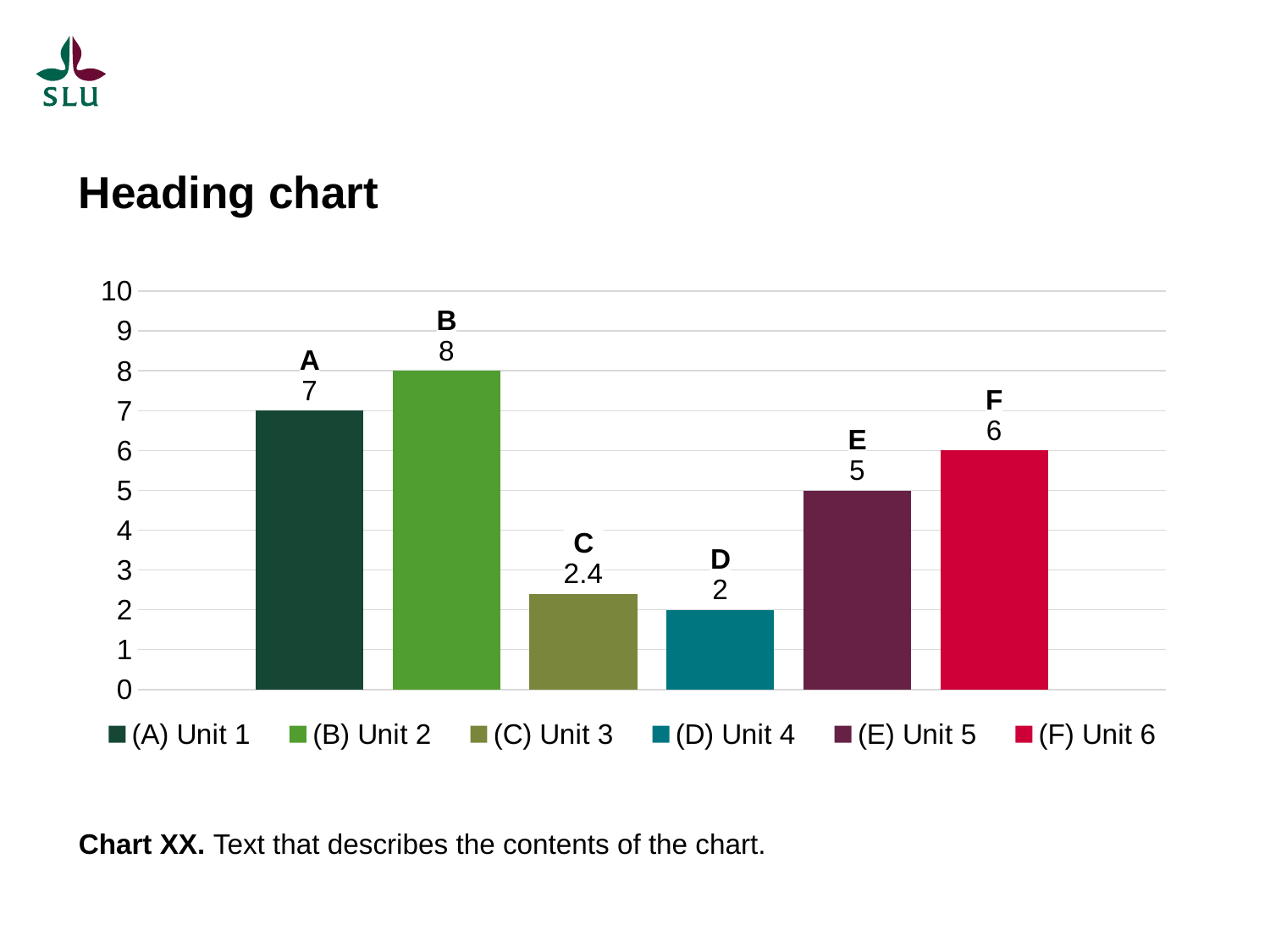
Is the value for (E) Unit 5 greater or less than 4? greater What is the value for (E) Unit 5? 5 How many bars are shown in the chart? 6 Which category has the lowest value? (D) Unit 4 How many entries does the legend list? 6 What is the value for (A) Unit 1? 7 Which category has the highest value? (B) Unit 2 What kind of chart is shown on the slide? bar chart What is the difference between the values for (B) Unit 2 and (D) Unit 4? 6 Which is larger, the value for (A) Unit 1 or the value for (F) Unit 6? (A) Unit 1 What is the value for (C) Unit 3? 2.4 What is the difference between the values for (F) Unit 6 and (C) Unit 3? 3.6